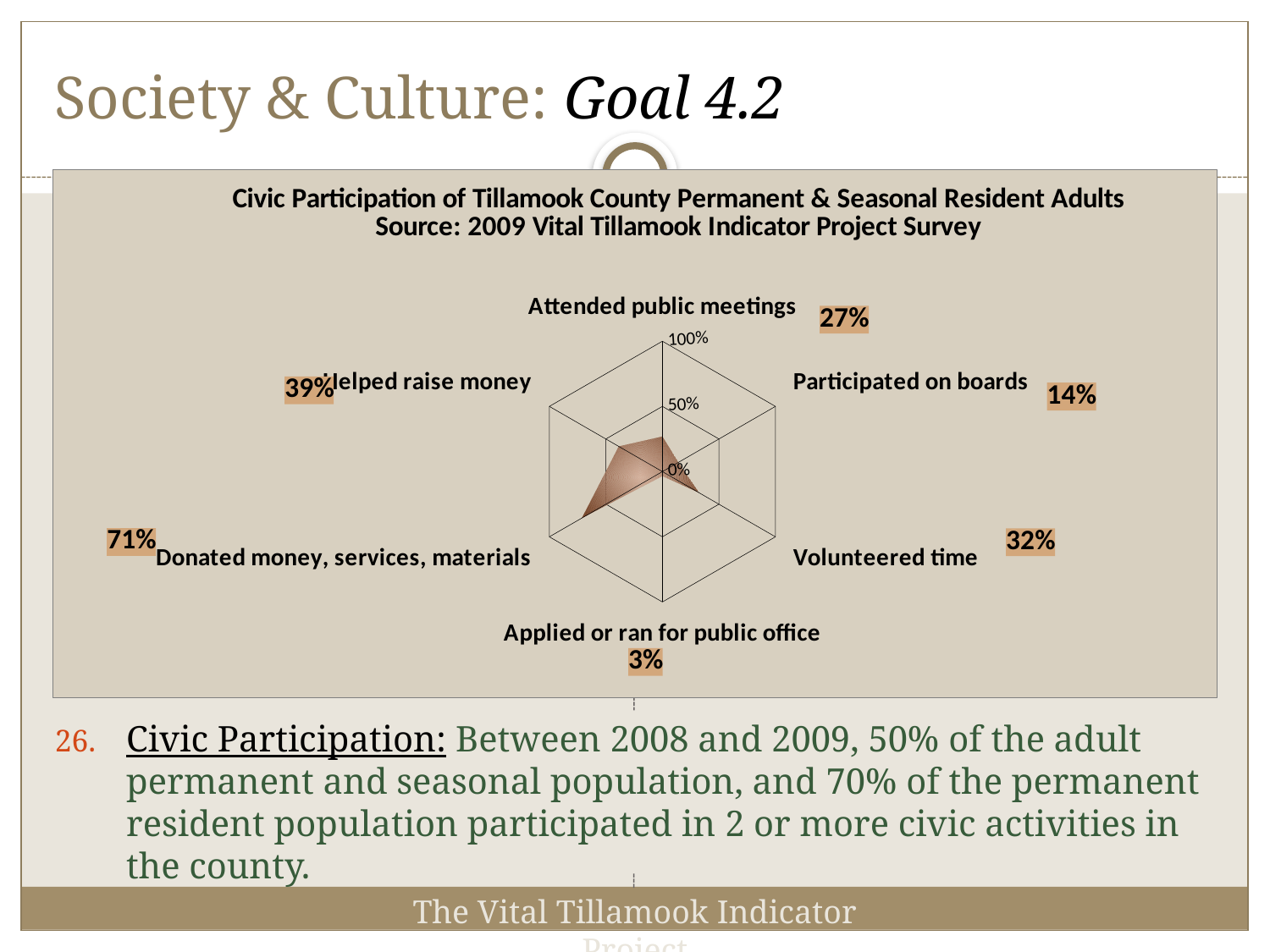
Which is larger: the percentage who volunteered time or the percentage who attended public meetings? Volunteered time What type of chart is shown on the slide? Radar chart What percentage of residents applied or ran for public office? 3% Which civic activity has the highest participation rate? Donated money, services, materials What percentage of residents attended public meetings? 27% What percentage of residents participated on boards? 14% Which civic activity has the lowest participation rate? Applied or ran for public office What percentage of residents donated money, services, materials? 71% What percentage of residents helped raise money? 39% What is the difference between the percentage who donated money, services, materials and the percentage who helped raise money? 32% What percentage of residents volunteered time? 32% How many civic activities are plotted on the chart? 6